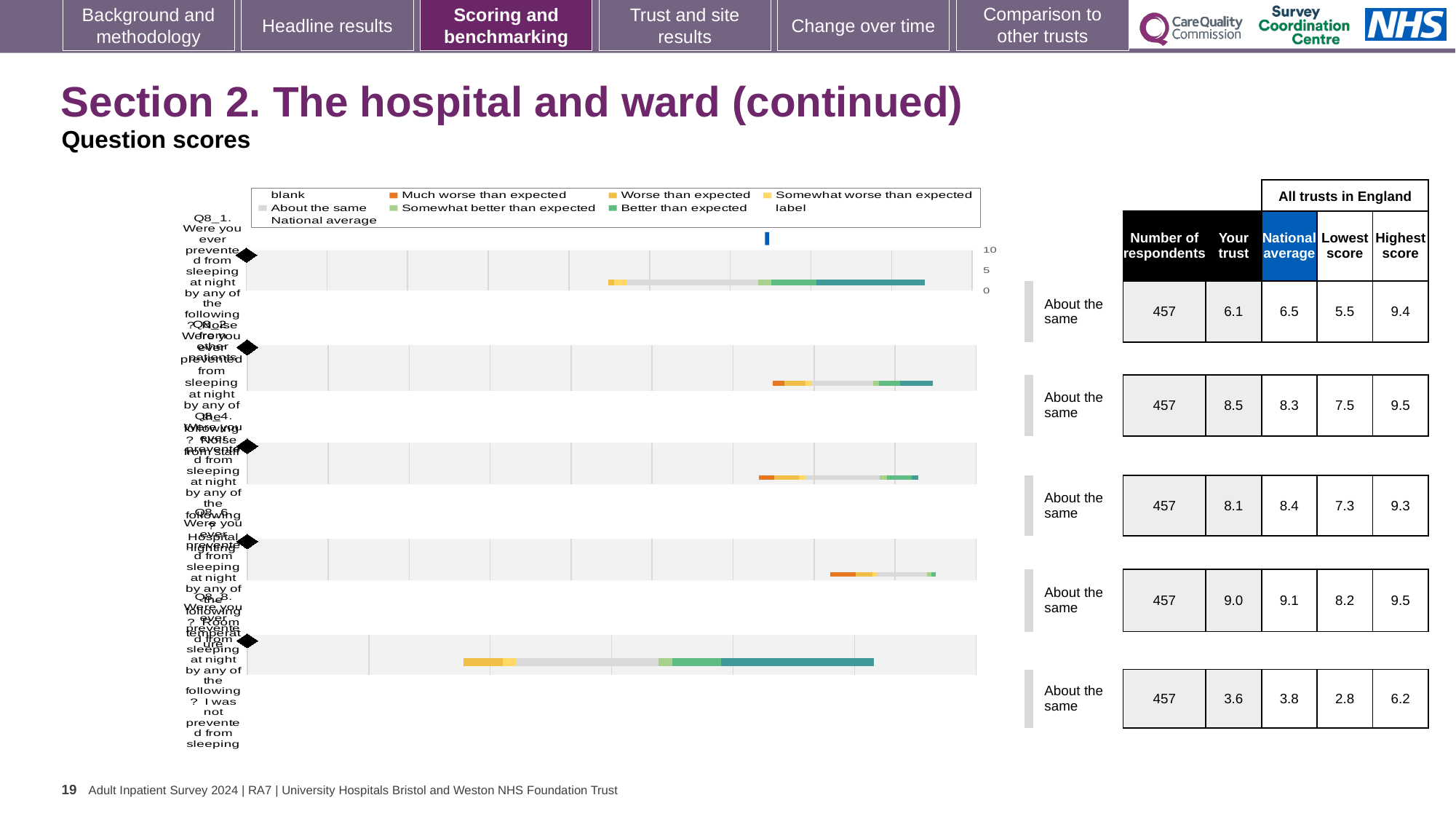
In the chart legend, which category is shown in dark orange? Much worse than expected How many question rows (bars) are plotted in the chart? 5 In the table, what is the highest score for the fourth row? 9.5 In the table, which row has the lowest 'Your trust' score? the last row (3.6) In the chart legend, which category is shown in grey? About the same In the table, is the 'Your trust' score for the second row larger or smaller than the national average for that row? larger In the table, what is the 'Your trust' score for the first row? 6.1 What kind of chart is shown on the slide? bar chart How many entries does the chart legend list? 9 In the table, what is the difference between the highest score and lowest score in the last row? 3.4 In the table, what is the number of respondents for the first row? 457 In the table, what is the 'Your trust' score for the last row? 3.6